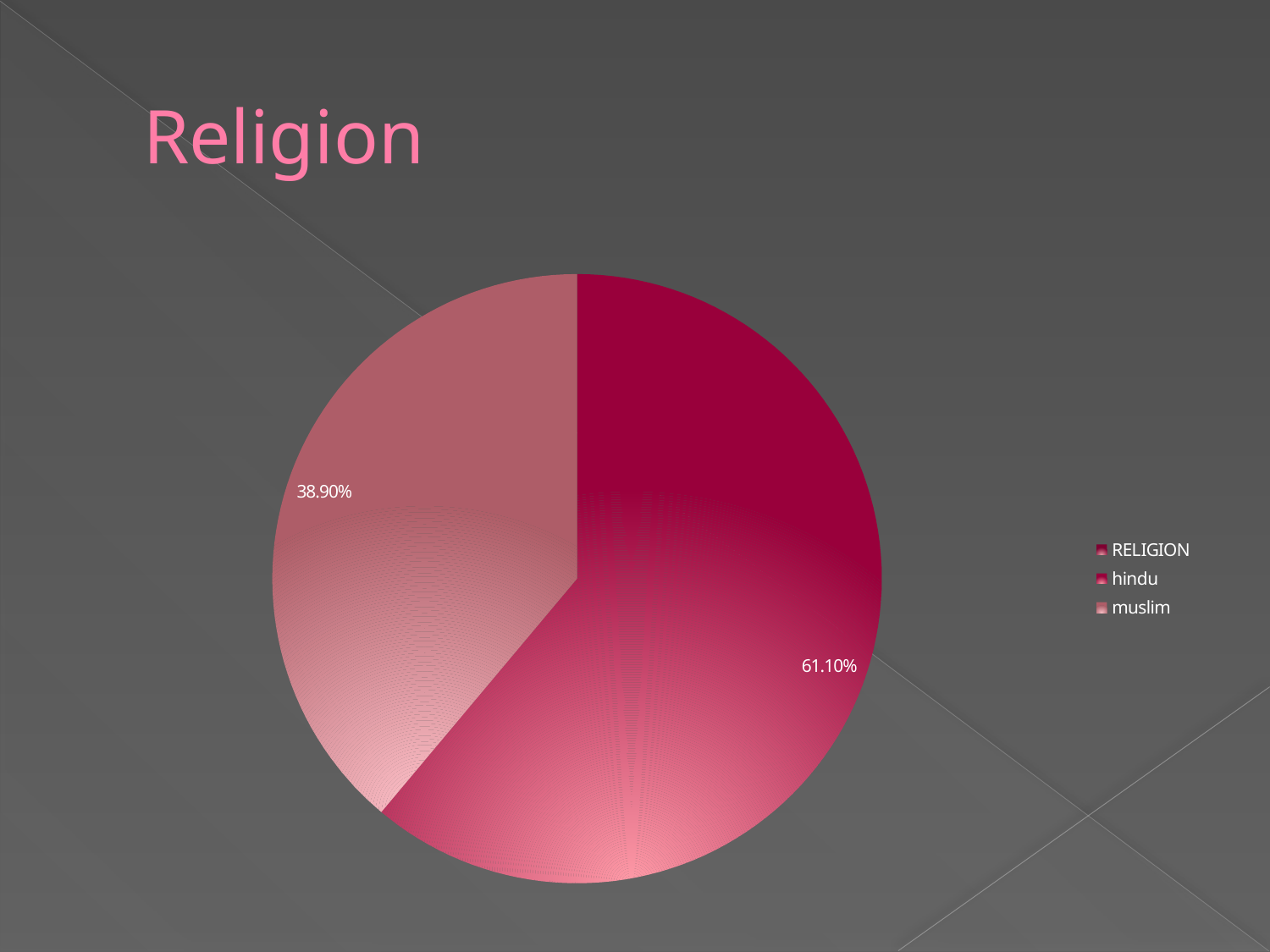
What percentage is printed on the larger slice of the pie chart? 61.10% Is the smaller slice of the pie chart greater or less than 40%? less What kind of chart is shown on the slide? pie chart What are the entries listed in the legend of the pie chart? RELIGION, hindu, muslim What is the difference between the two percentages printed on the pie chart? 22.20% Is the larger slice of the pie chart greater or less than 50%? greater How many slices are visible in the pie chart? 2 How many entries does the legend of the pie chart list? 3 Which printed value on the pie chart is larger, 61.10% or 38.90%? 61.10% What percentage is printed on the smaller slice of the pie chart? 38.90% What do the two printed percentages on the pie chart add up to? 100.00% What is the title of the slide containing the pie chart? Religion